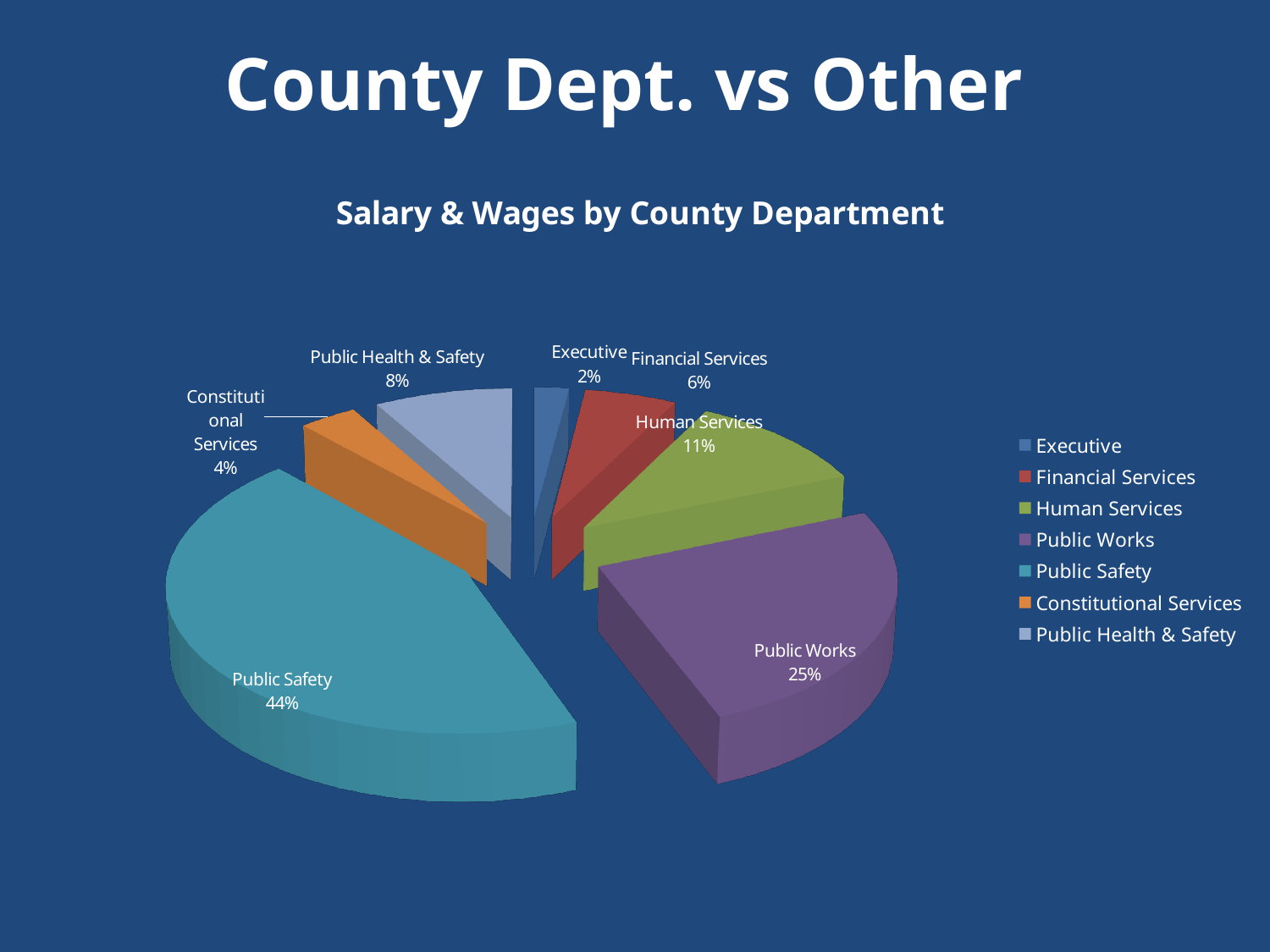
Which department has the smallest share? Executive What share of salary and wages goes to Public Safety? 44% How many departments are shown in the pie chart? 7 What is the value shown for Human Services? 11% Which is larger, the share for Public Health & Safety or the share for Financial Services? Public Health & Safety What is the difference in percentage points between Public Safety and Public Works? 19 What percentage does Public Works account for? 25% Which department has the largest share of salary and wages? Public Safety What colour is the Public Works slice? Purple What percentage is shown for Constitutional Services? 4% What is the title of the chart? Salary & Wages by County Department What type of chart is shown on the slide? Pie chart